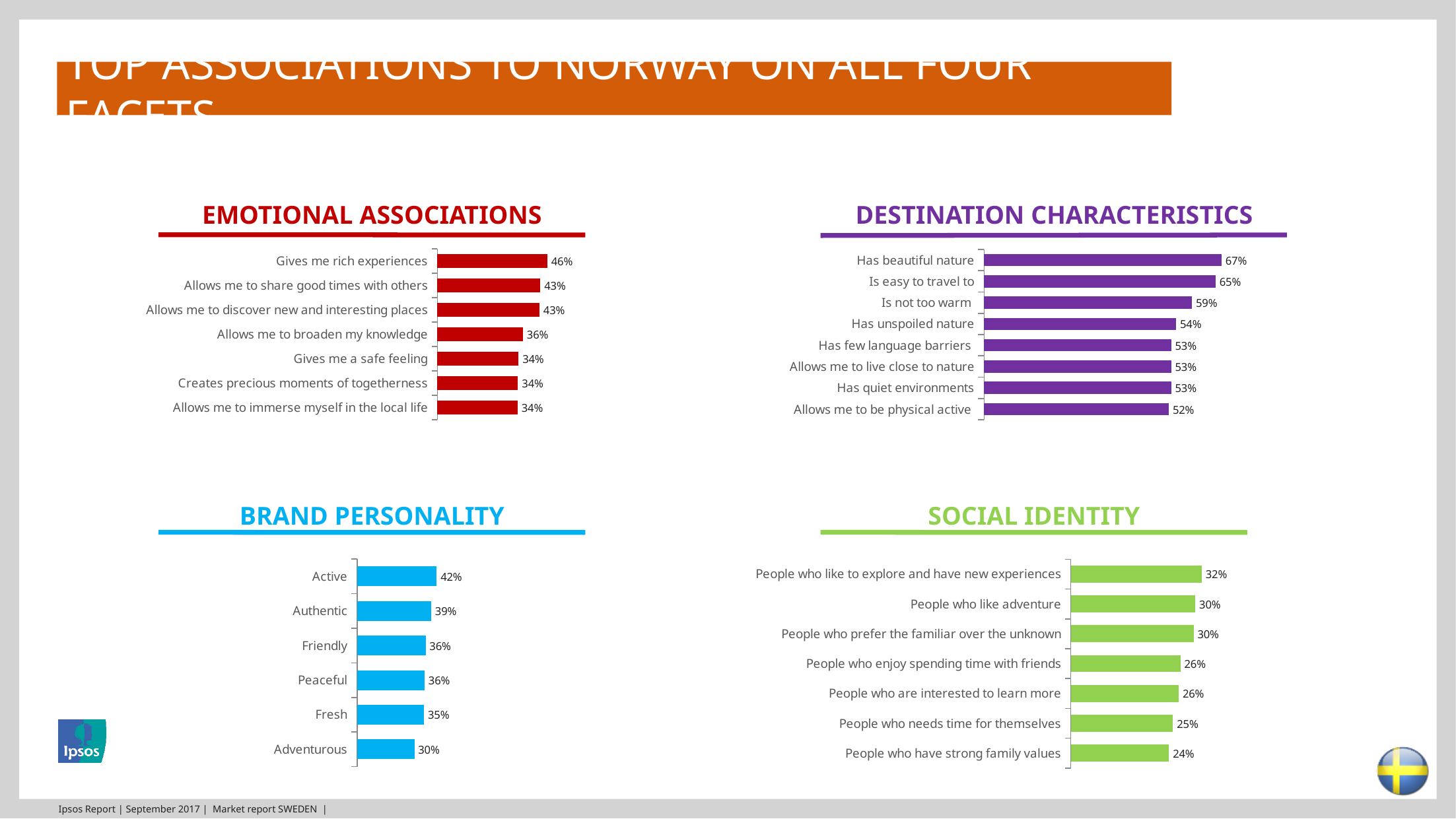
What type of chart is the Brand Personality chart? Bar chart In the Brand Personality chart, what is the difference between the values for 'Active' and 'Adventurous'? 12% In the Emotional Associations chart, what percentage is shown for 'Gives me rich experiences'? 46% In the Destination Characteristics chart, which category has the highest value? Has beautiful nature In the Emotional Associations chart, which is larger: 'Allows me to broaden my knowledge' or 'Gives me a safe feeling'? Allows me to broaden my knowledge In the Destination Characteristics chart, what is the difference between 'Has beautiful nature' and 'Allows me to be physical active'? 15% In the Social Identity chart, what is the value for 'People who like adventure'? 30% What colour are the bars in the Social Identity chart? Green In the Destination Characteristics chart, what is the value for 'Is not too warm'? 59% In the Social Identity chart, how many categories are plotted? 7 In the Brand Personality chart, which category has the lowest value? Adventurous In the Destination Characteristics chart, how many categories are plotted? 8